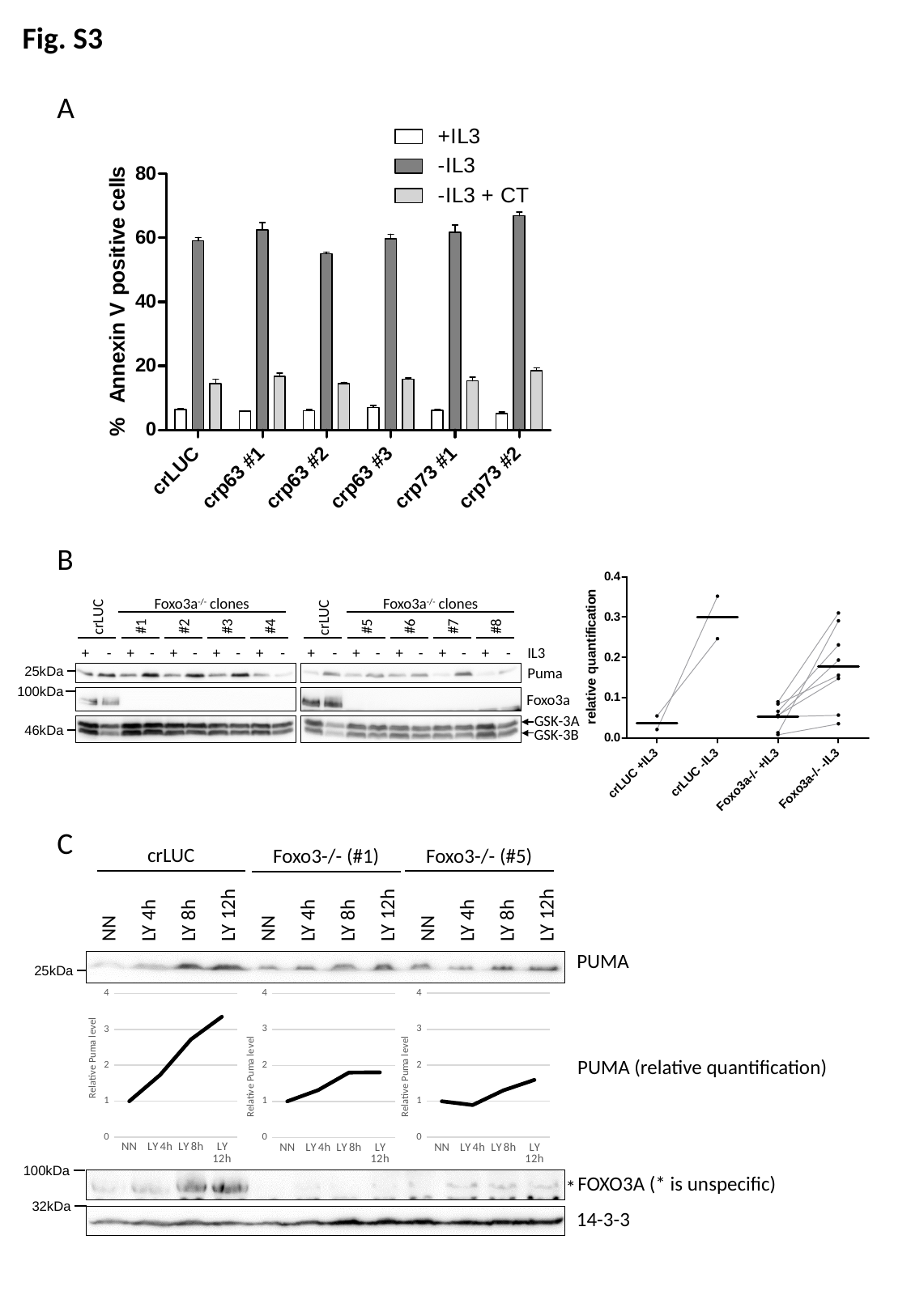
In panel A, which category has the lowest -IL3 value? crp63 #2 In panel C, do the values in the crLUC PUMA relative quantification chart rise or fall from NN to LY 12h? rise In the panel B dot plot, is the mean line for crLUC -IL3 greater or less than 0.2? greater In panel A, which category has the highest -IL3 value? crp73 #2 In panel A, how many categories are shown on the x axis? 6 In panel A, what kind of chart is shown? bar chart In panel A, is the -IL3 value for crLUC greater or less than 40? greater In panel A, is the -IL3 + CT value for crp73 #2 greater or less than 20? less In panel A, which is larger for crp63 #1: the -IL3 value or the -IL3 + CT value? -IL3 In panel A, how many series does the legend list? 3 In the panel B dot plot, how many categories are shown on the x axis? 4